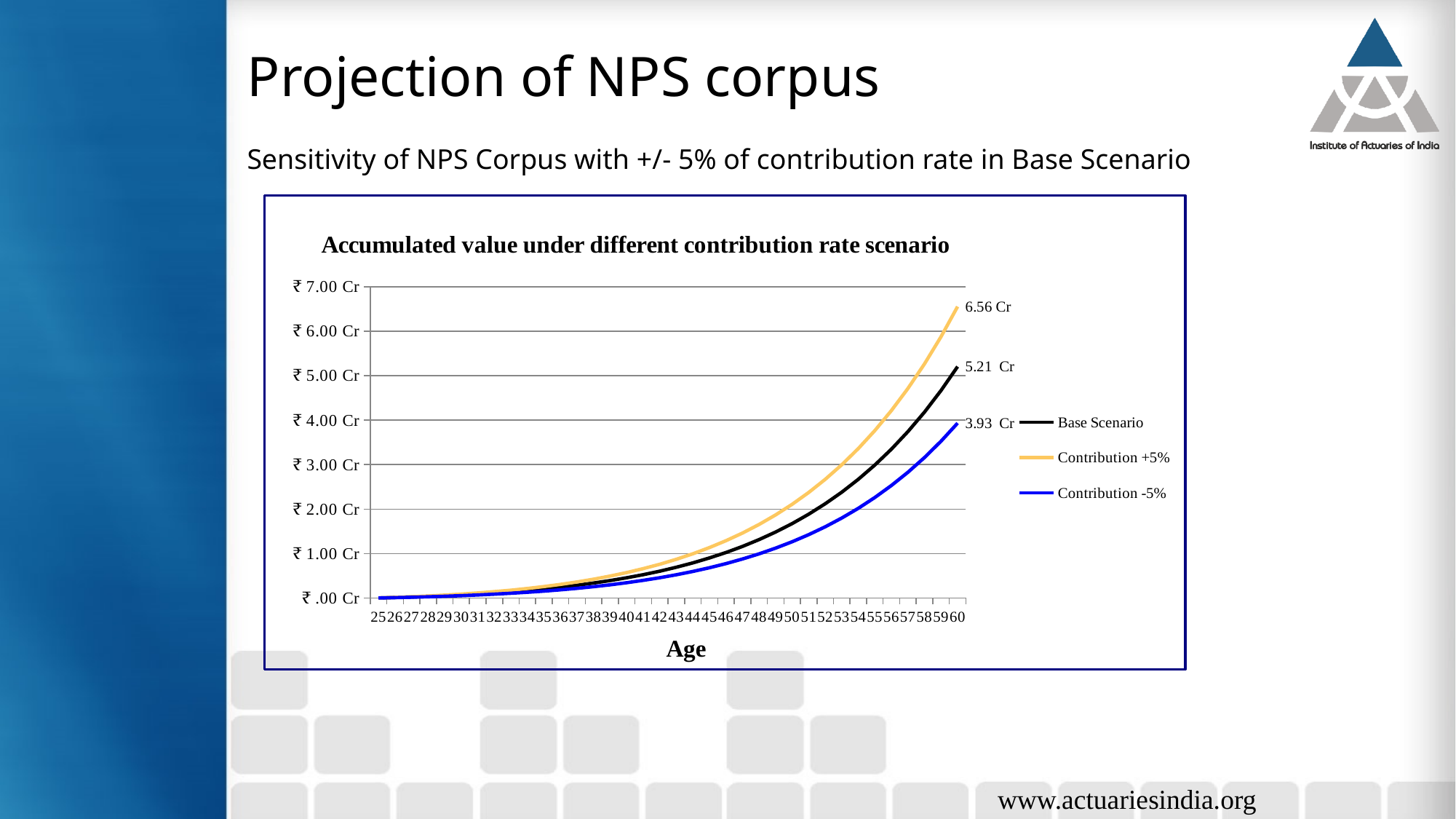
What is the accumulated value at age 60 under the Base Scenario? 5.21 Cr What is the difference between the Contribution +5% and Base Scenario values at age 60? 1.35 Cr Which scenario has the lowest accumulated value at age 60? Contribution -5% How many series does the chart's legend list? 3 What is the title of the chart's x axis? Age Is the Base Scenario value at age 50 greater or less than ₹ 3.00 Cr? less What is the difference between the Contribution +5% and Contribution -5% values at age 60? 2.63 Cr What is the accumulated value at age 60 under the Contribution +5% scenario? 6.56 Cr Do the accumulated values rise or fall as age increases? Rise Which scenario has the highest accumulated value at age 60? Contribution +5% What kind of chart is shown on the slide? Line chart What is the accumulated value at age 60 under the Contribution -5% scenario? 3.93 Cr